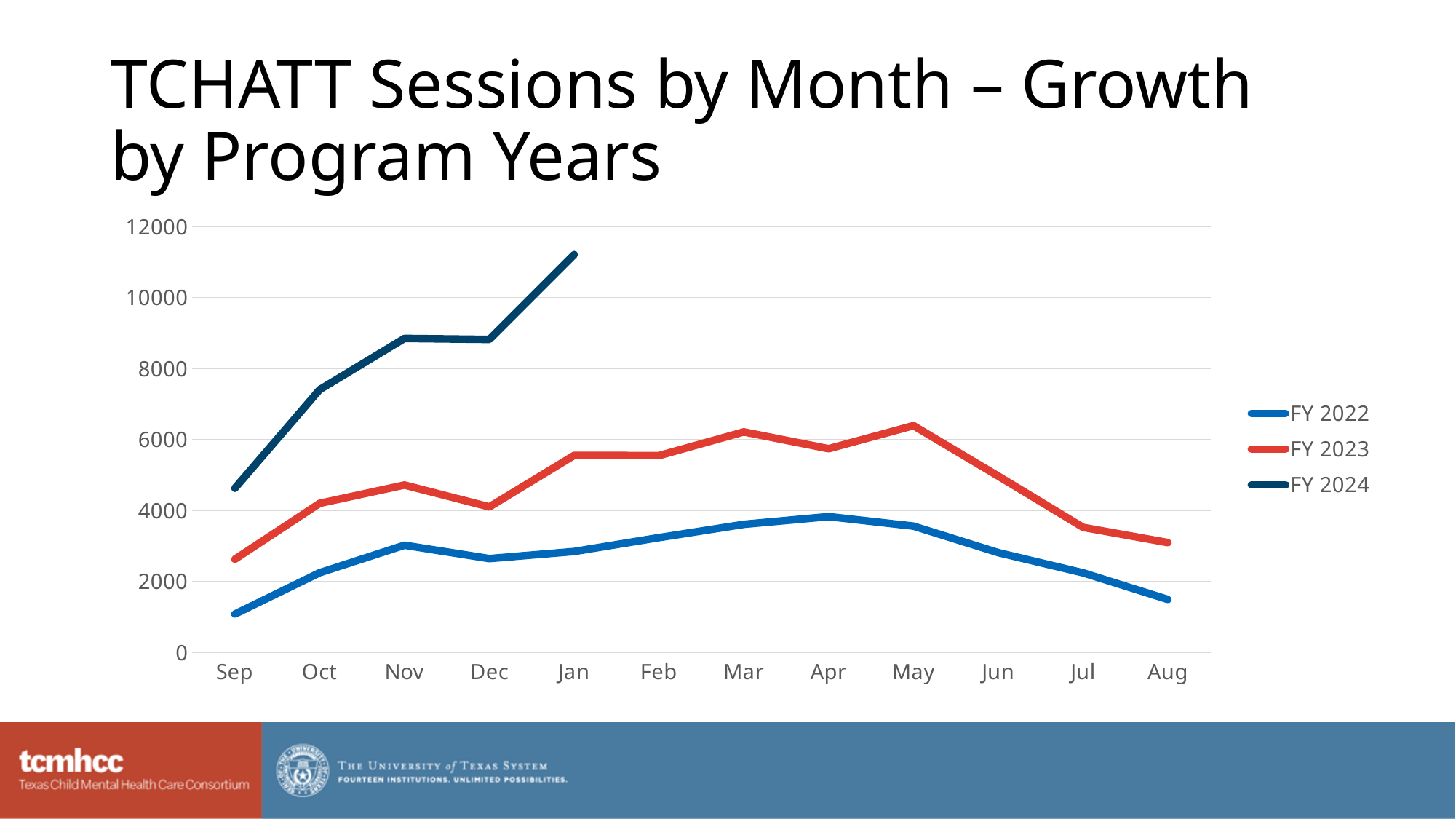
In Mar, which series has the larger value, FY 2022 or FY 2023? FY 2023 How many months are shown along the x axis? 12 In which month is the FY 2023 line at its lowest value? Sep In which month does the FY 2024 line reach its highest value? Jan What kind of chart is shown on the slide? Line chart How many series does the legend list? 3 Is the FY 2023 value for Aug greater or less than 4000? less Does the FY 2024 line rise or fall from Sep to Jan? Rises In which month does the FY 2022 line reach its highest value? Apr Is the FY 2024 value for Jan greater or less than 10000? greater Is the FY 2022 value for Sep greater or less than 2000? less In which month is the FY 2022 line at its lowest value? Sep